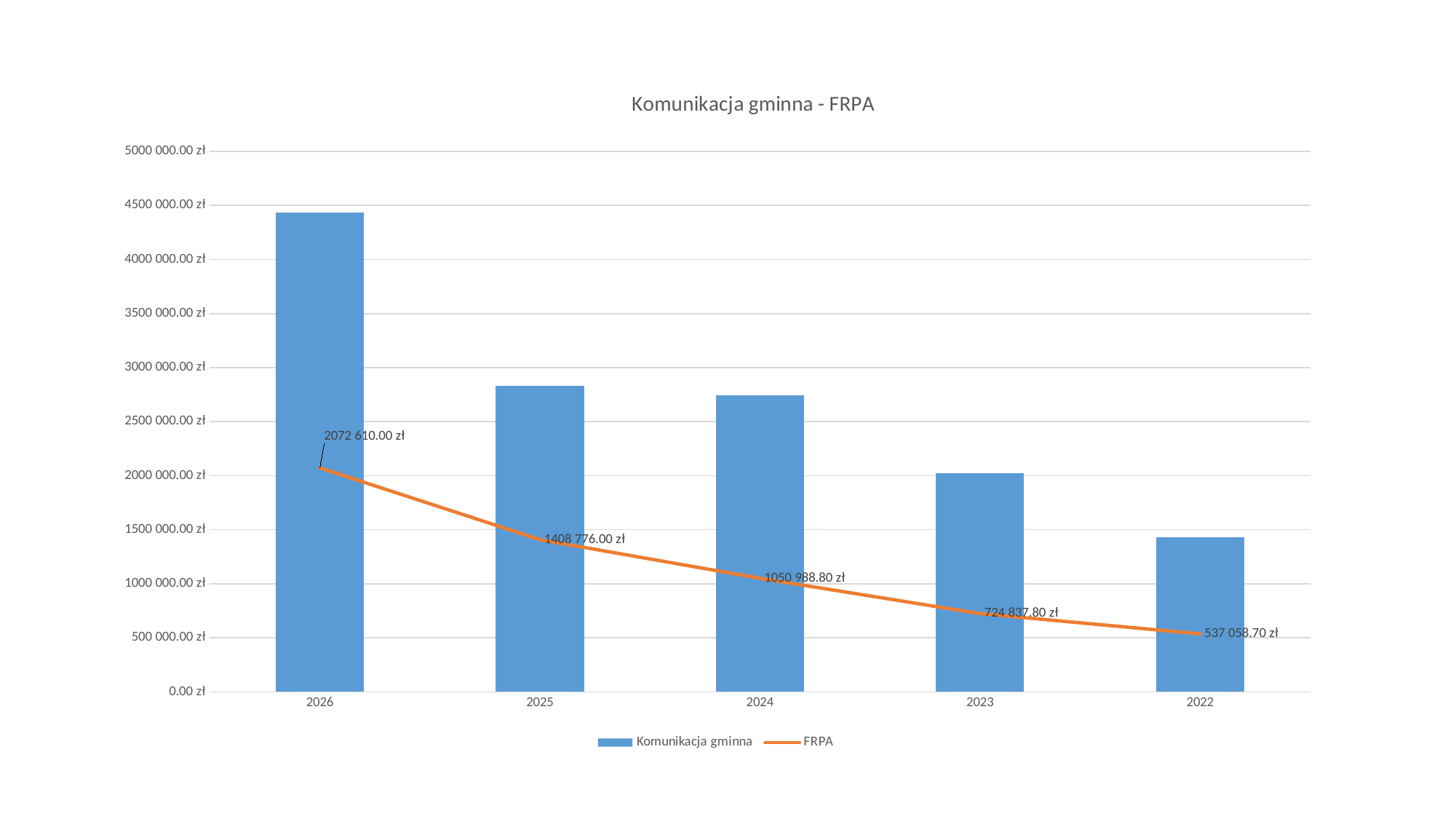
How many years are shown on the x axis? 5 What is the FRPA value for 2026? 2072 610.00 zł Which year has the highest FRPA value? 2026 What is the difference between the FRPA values for 2026 and 2025? 663 834.00 zł Does the FRPA line rise or fall from 2026 to 2022 along the x axis? fall Is the Komunikacja gminna value for 2026 greater or less than 4000 000.00 zł? greater Is the Komunikacja gminna value for 2023 greater or less than 2500 000.00 zł? less How many series does the legend list? 2 What is the FRPA value for 2023? 724 837.80 zł What is the FRPA value for 2024? 1050 988.80 zł What is the FRPA value for 2022? 537 058.70 zł Which year has the lowest Komunikacja gminna value? 2022